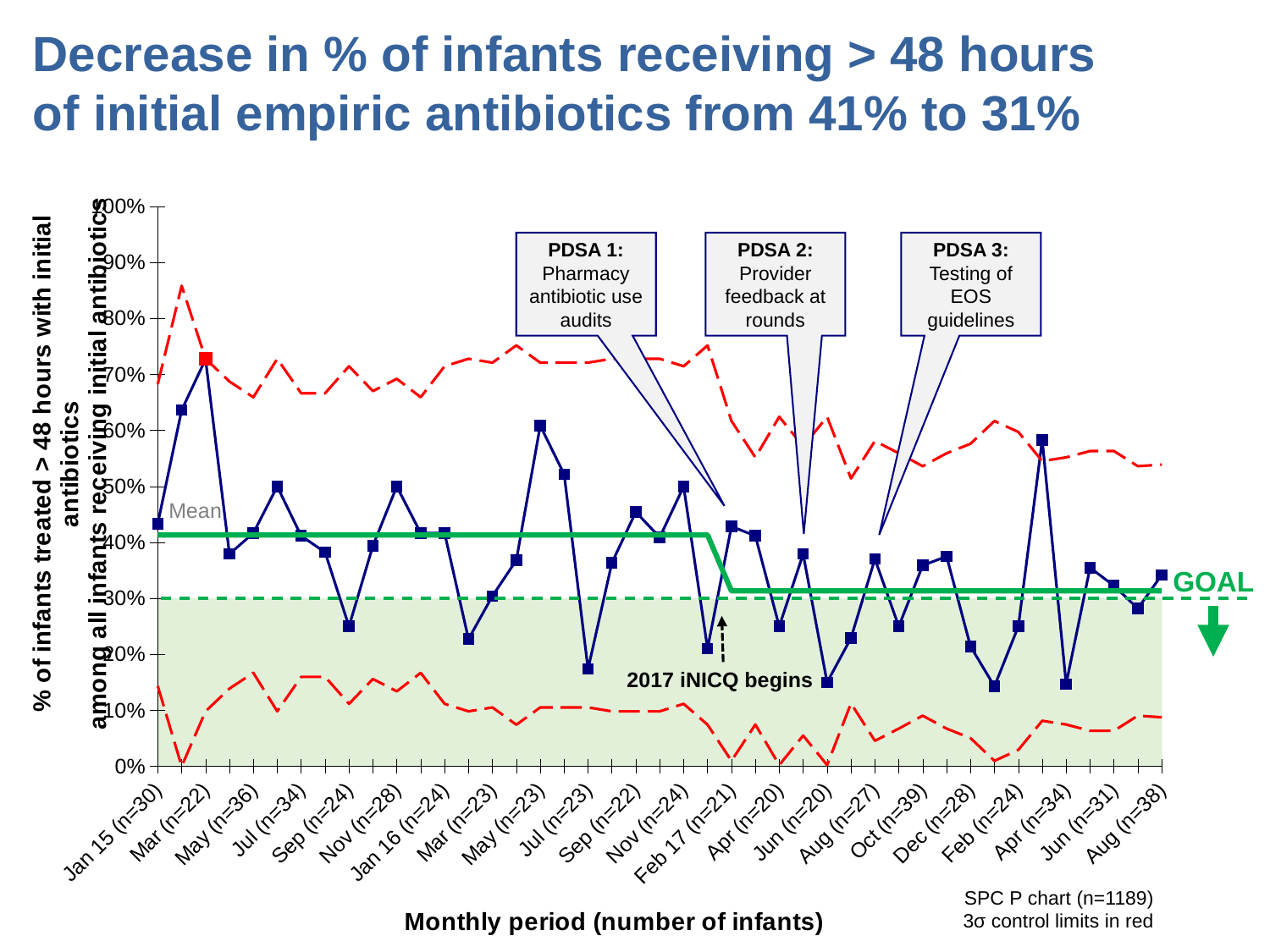
Which is larger, the value for Apr (n=34) in 2018 or the value for Jun (n=31) in 2018? Jun (n=31) What kind of chart is shown on the slide? line chart Is the value for Jul 16 (n=23) greater or less than 20%? less Is the value for Mar (n=22) in 2015 greater or less than 70%? greater Which is larger, the value for Jul 16 (n=23) or the value for Sep (n=22) in 2016? Sep (n=22) What was the mean % of infants receiving > 48 hours of antibiotics before the decrease, according to the title? 41% Is the value for Jun (n=20) in 2017 greater or less than 20%? less Which monthly period has the highest % of infants treated > 48 hours? Mar (n=22) Do the plotted values generally rise or fall from left to right across the monthly periods? fall By how many percentage points did the mean decrease, from 41% to 31%? 10 percentage points At what percentage is the dashed GOAL line drawn? 30%